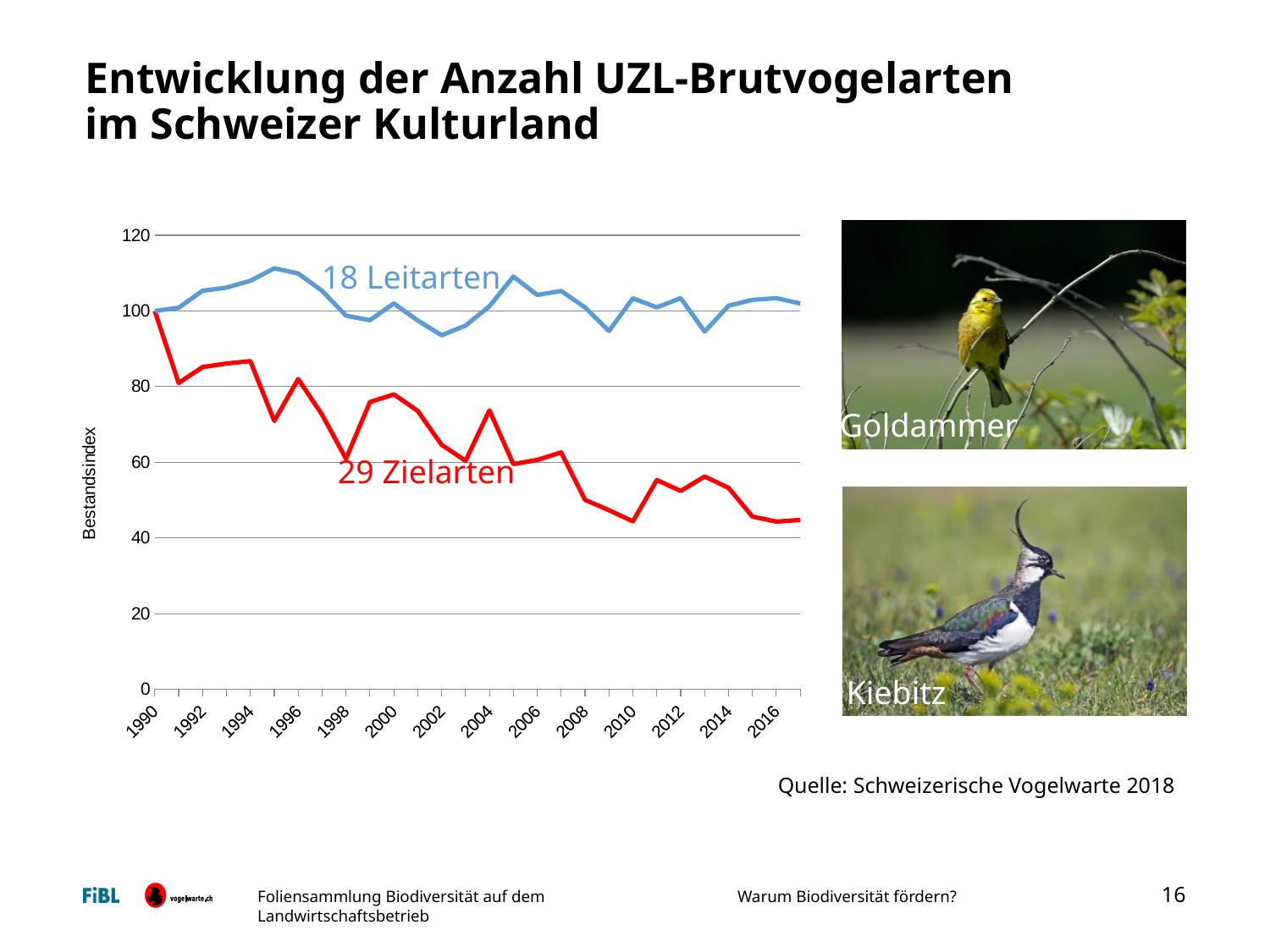
Is the value for 18 Leitarten in 2002 greater or less than 100? less What is the first year and the last year shown on the x axis? 1990 and 2016 How many data series are plotted in the chart? 2 What kind of chart is shown on the slide? line chart What is the Bestandsindex value for 18 Leitarten in 1990? 100 Does the 29 Zielarten line rise or fall overall from 1990 to 2016? fall What is the Bestandsindex value for 29 Zielarten in 1990? 100 What is the label of the vertical axis? Bestandsindex Which series has the higher value in 2016, 18 Leitarten or 29 Zielarten? 18 Leitarten Is the value for 29 Zielarten in 1992 greater or less than 80? greater Is the value for 29 Zielarten in 2016 greater or less than 60? less In which year does the 29 Zielarten series reach its highest value? 1990